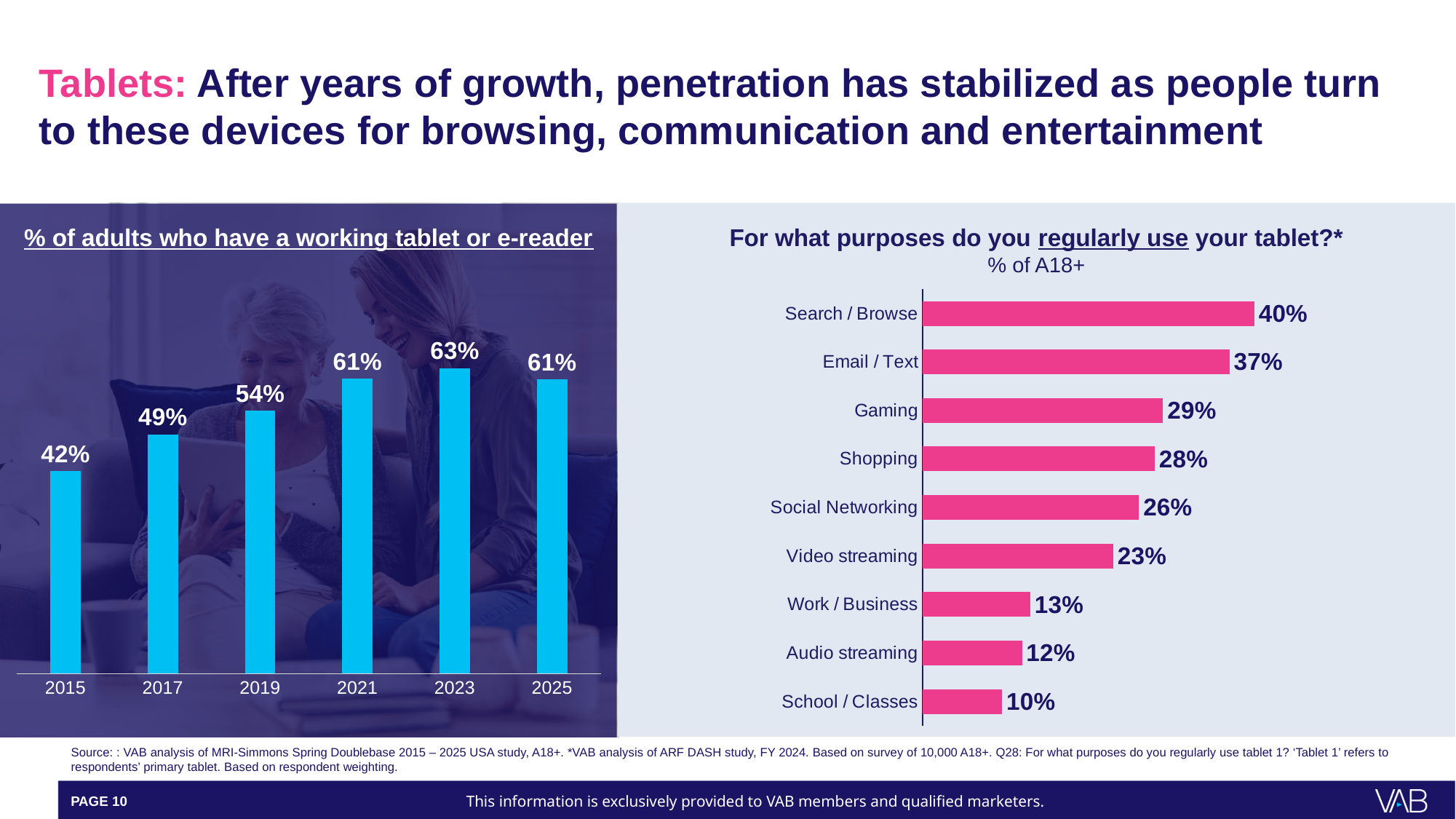
In the right chart 'For what purposes do you regularly use your tablet?', what is the value for Gaming? 29% What colour are the bars in the right chart 'For what purposes do you regularly use your tablet?'? pink In the right chart 'For what purposes do you regularly use your tablet?', which purpose has the lowest value? School / Classes In the left chart '% of adults who have a working tablet or e-reader', do the values generally rise or fall from 2015 to 2023? rise In the left chart '% of adults who have a working tablet or e-reader', which year has the highest value? 2023 In the right chart 'For what purposes do you regularly use your tablet?', what is the difference between Search / Browse and Email / Text? 3 percentage points What kind of chart is the left chart '% of adults who have a working tablet or e-reader'? bar chart In the right chart 'For what purposes do you regularly use your tablet?', which is larger: Shopping or Video streaming? Shopping In the left chart '% of adults who have a working tablet or e-reader', how many years are shown on the x axis? 6 In the left chart '% of adults who have a working tablet or e-reader', what is the difference between the 2023 and 2015 values? 21 percentage points In the left chart '% of adults who have a working tablet or e-reader', what is the value for 2015? 42% In the right chart 'For what purposes do you regularly use your tablet?', how many purposes are listed? 9